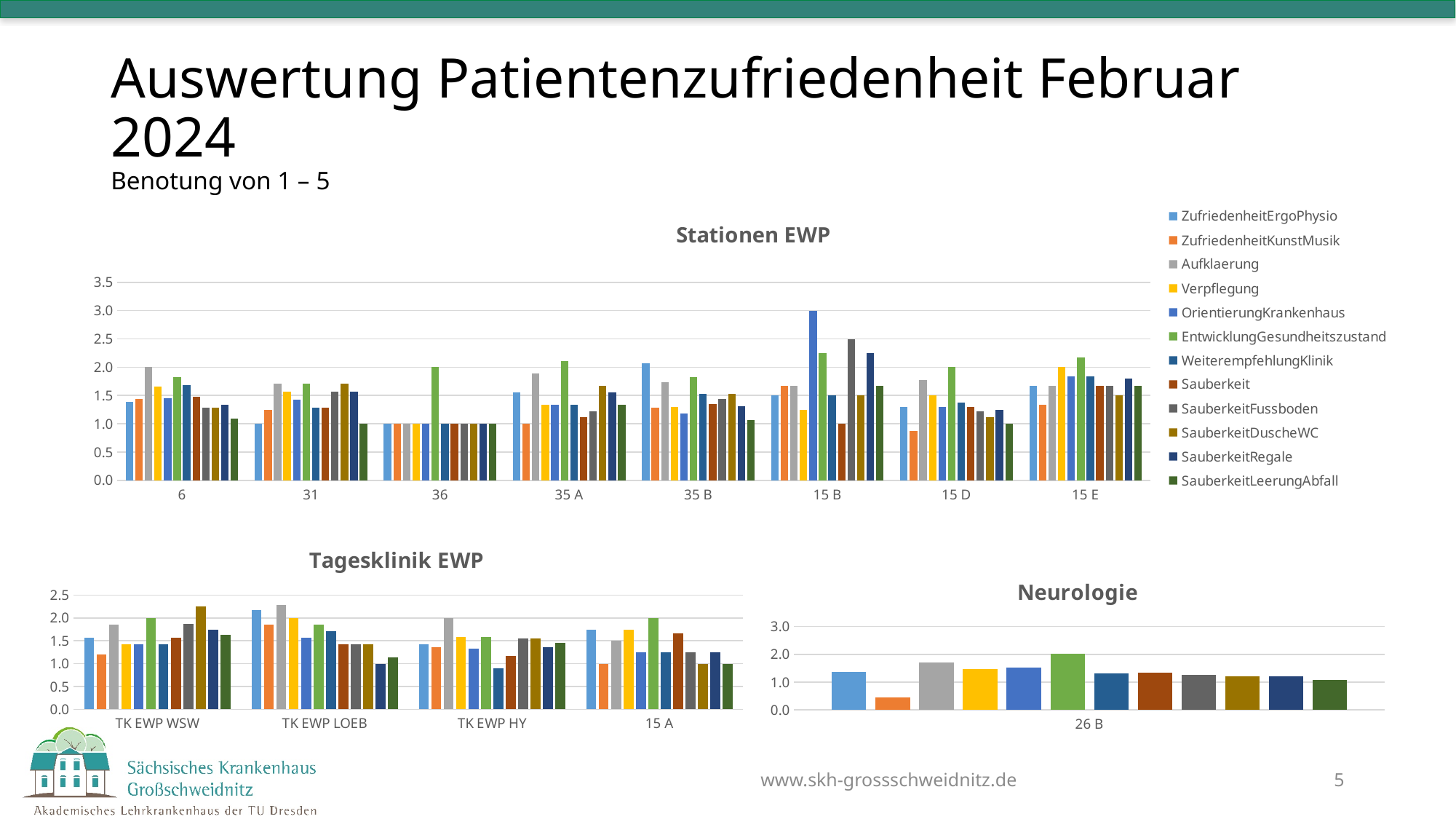
In the "Stationen EWP" chart, is the value for OrientierungKrankenhaus at station 15 B greater or less than 2.5? greater In the "Stationen EWP" chart, which station has the single highest bar? 15 B In the "Neurologie" chart, is the value for ZufriedenheitKunstMusik at 26 B greater or less than 1.0? less What kind of chart is the "Stationen EWP" chart? bar chart How many series does the legend list for the charts on the slide? 12 In the "Stationen EWP" chart, what is the value for Aufklaerung at station 36? 1.0 In the "Stationen EWP" chart, at station 6, which is larger: Aufklaerung or ZufriedenheitErgoPhysio? Aufklaerung In the "Tagesklinik EWP" chart, is the value for ZufriedenheitErgoPhysio at TK EWP LOEB greater or less than 1.5? greater What is the title of the chart at the bottom right of the slide? Neurologie In the "Neurologie" chart, which series has the lowest bar for 26 B? ZufriedenheitKunstMusik How many categories (stations) are shown on the x axis of the "Stationen EWP" chart? 8 How many categories are shown on the x axis of the "Tagesklinik EWP" chart? 4